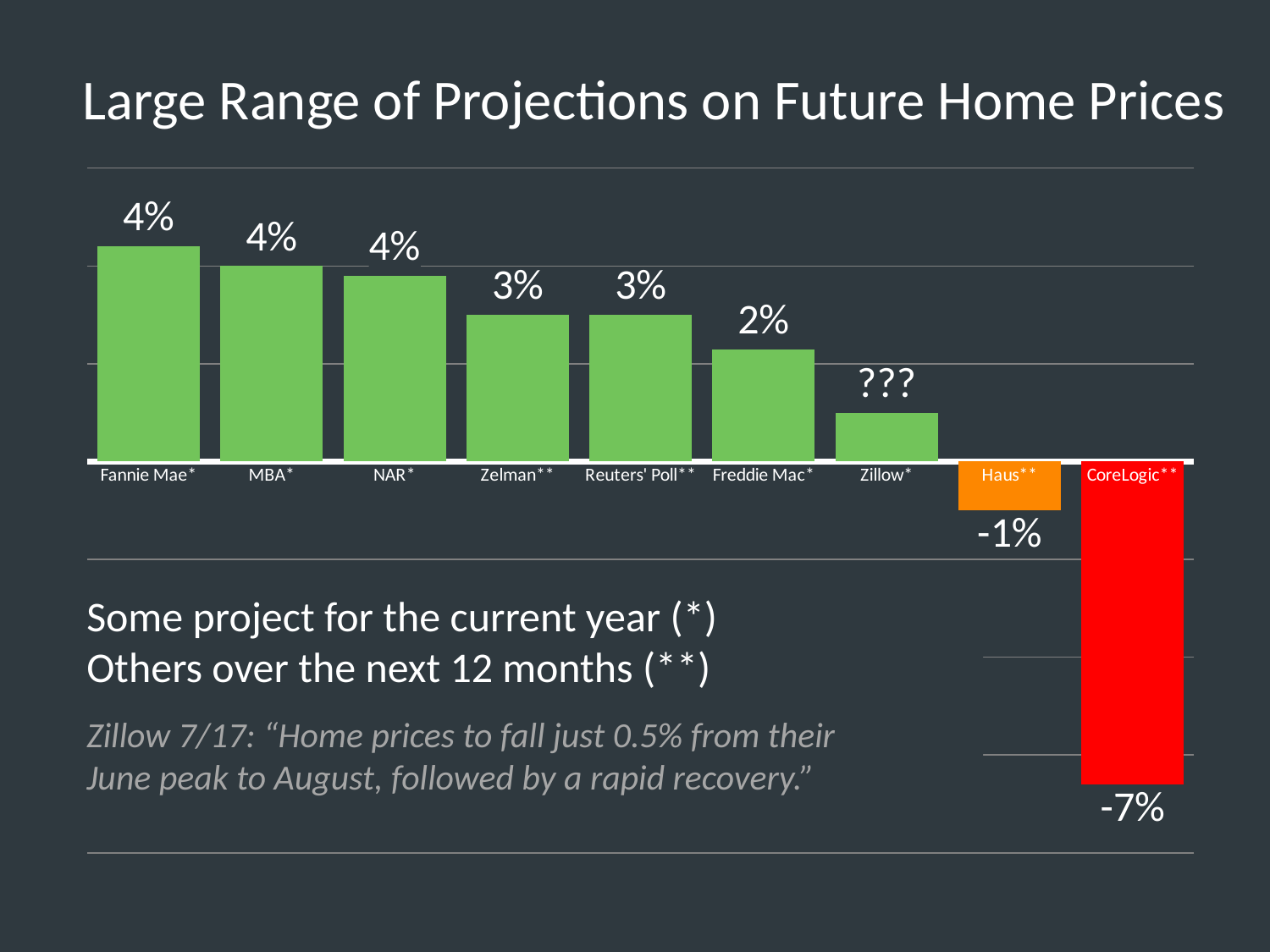
Which category has the lowest projected value? CoreLogic** What value is shown for Freddie Mac*? 2% Do the values rise or fall moving from left to right across the chart? Fall What value is shown for CoreLogic**? -7% Which is larger, the value for Zelman** or the value for Freddie Mac*? Zelman** What is the projected home price change for Fannie Mae*? 4% What value is shown for Haus**? -1% What kind of chart is shown on the slide? Bar chart What is the difference between the Fannie Mae* value and the CoreLogic** value? 11 percentage points What label appears above the Zillow* bar instead of a value? ??? How many categories are shown on the chart? 9 What value is shown for Zelman**? 3%